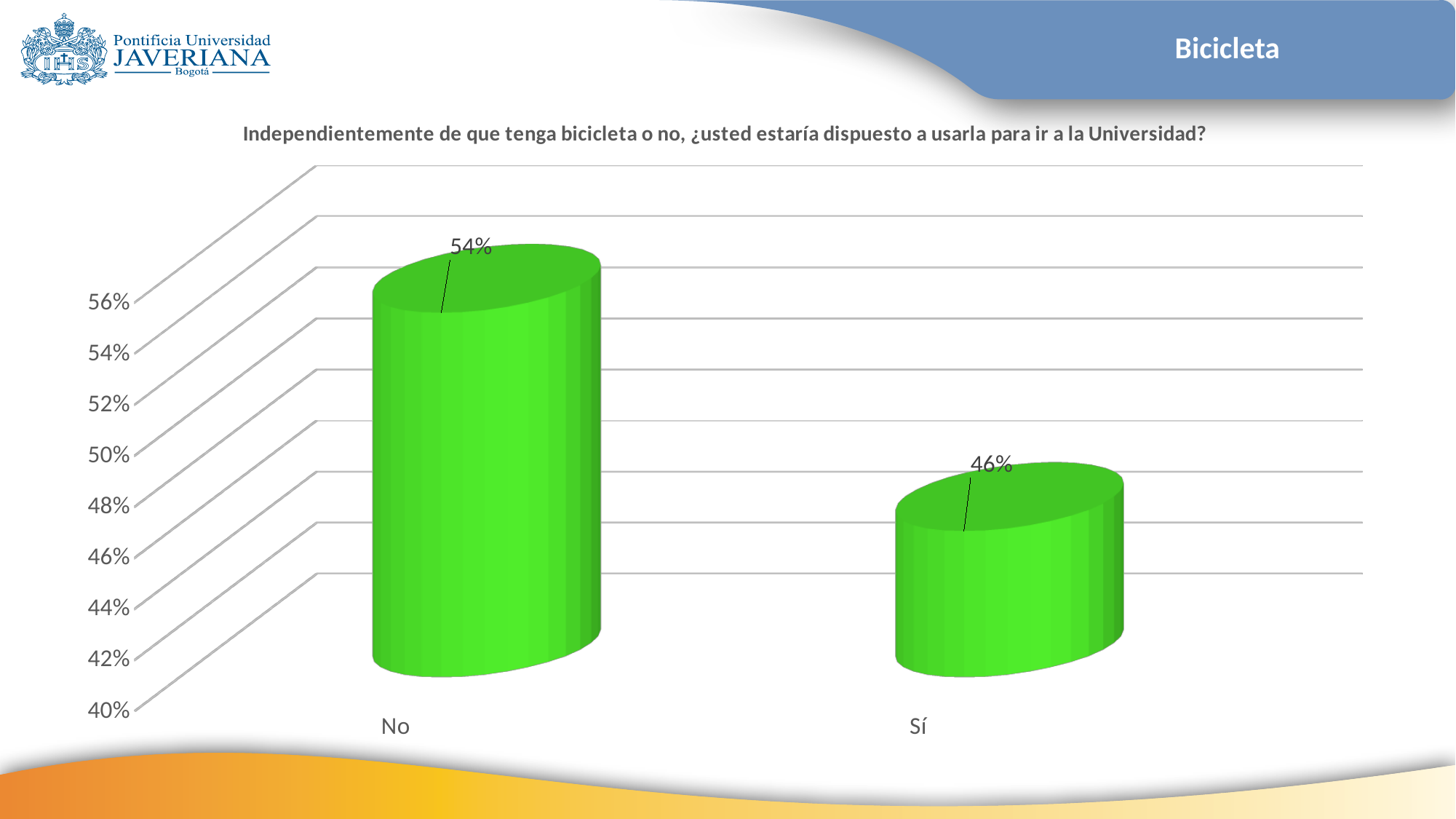
Which category has the highest value? No What is the value for "No"? 54% What is the lowest value shown on the vertical axis? 40% What is the value for "Sí"? 46% Which category has the lowest value? Sí Which is larger, the value for "No" or the value for "Sí"? No What is the difference between the values for "No" and "Sí"? 8% What is the title of the chart? Independientemente de que tenga bicicleta o no, ¿usted estaría dispuesto a usarla para ir a la Universidad? Is the value for "Sí" greater or less than 50%? less Is the value for "No" greater or less than 50%? greater What kind of chart is shown on the slide? bar chart How many categories are shown on the chart? 2